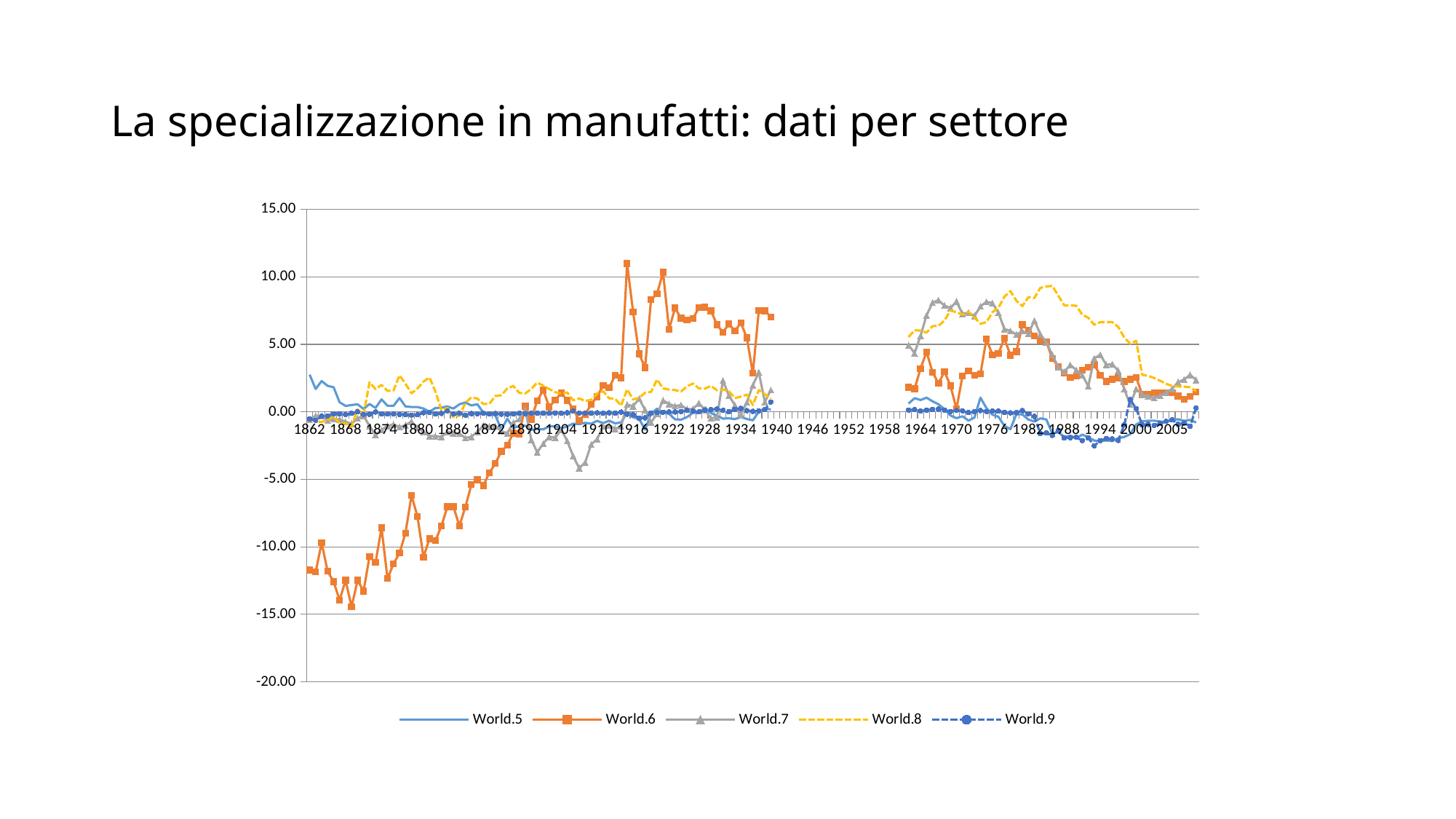
What kind of chart is shown on the slide? Line chart Around 1988, which series is higher: World.8 or World.9? World.8 Is the peak value of World.6 around 1916 greater or less than 10.00? greater Does the World.6 series rise or fall between 1862 and 1916? rise Is the value for World.6 in 1862 greater or less than -10.00? less Is the value for World.8 around 1988 greater or less than 5.00? greater Which series has the lowest value at the start of the chart, in 1862? World.6 How many series does the legend list? 5 Which series is plotted with a yellow dashed line? World.8 Which series reaches the highest value on the chart, around 1916? World.6 What is the title of the slide containing the chart? La specializzazione in manufatti: dati per settore